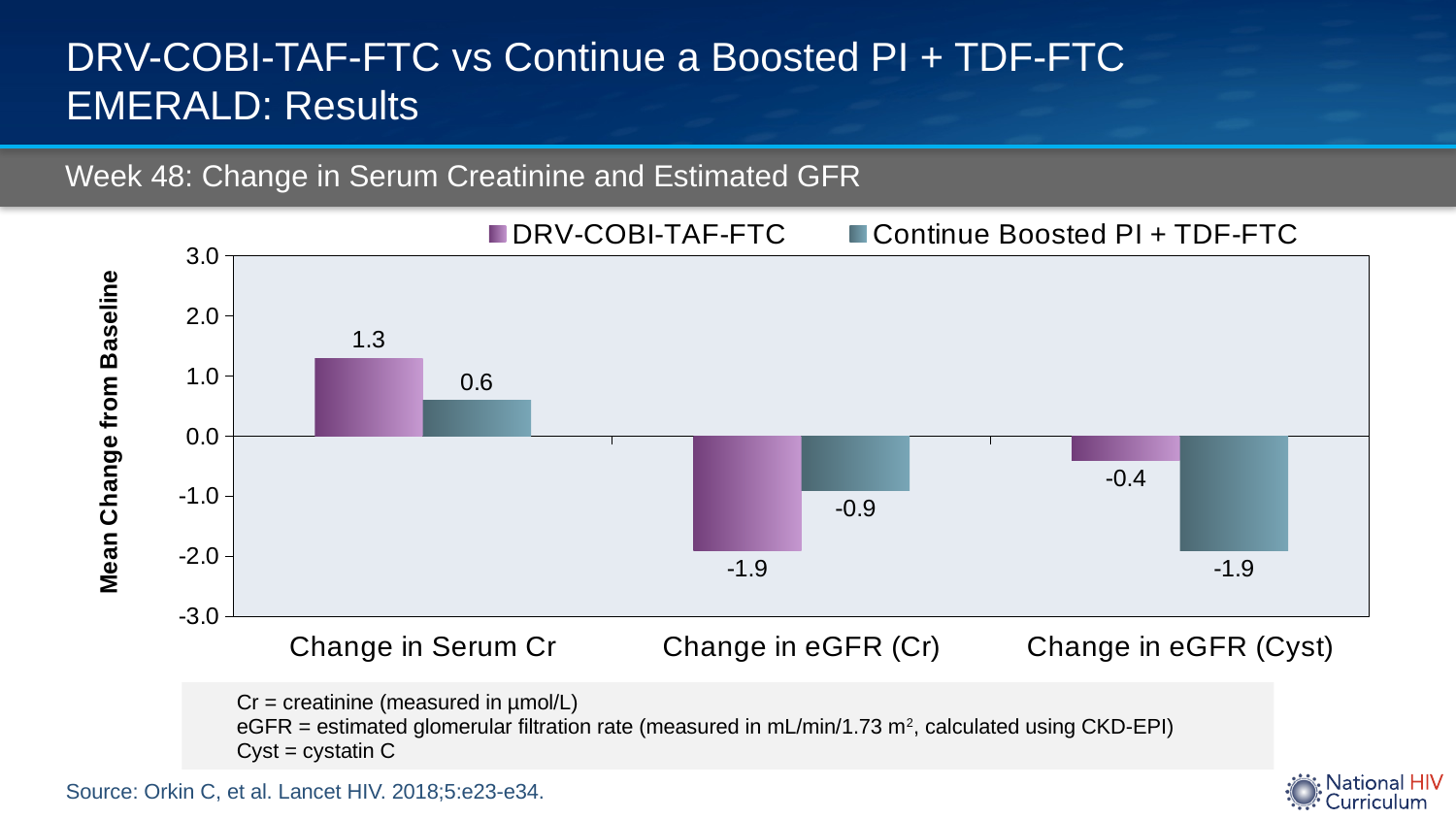
What type of chart is shown on the slide? Bar chart What is the difference between the DRV-COBI-TAF-FTC and Continue Boosted PI + TDF-FTC values for change in eGFR (Cr)? 1.0 Which series has the larger change in serum Cr, DRV-COBI-TAF-FTC or Continue Boosted PI + TDF-FTC? DRV-COBI-TAF-FTC How many categories are shown on the x axis? 3 How many series does the legend list? 2 What is the mean change in eGFR (Cyst) for DRV-COBI-TAF-FTC? -0.4 What is the mean change in eGFR (Cyst) for Continue Boosted PI + TDF-FTC? -1.9 What is the mean change in serum Cr for Continue Boosted PI + TDF-FTC? 0.6 Which category has the highest value for DRV-COBI-TAF-FTC? Change in Serum Cr What is the mean change in serum Cr for DRV-COBI-TAF-FTC? 1.3 What is the difference between the DRV-COBI-TAF-FTC and Continue Boosted PI + TDF-FTC values for change in serum Cr? 0.7 What is the mean change in eGFR (Cr) for DRV-COBI-TAF-FTC? -1.9